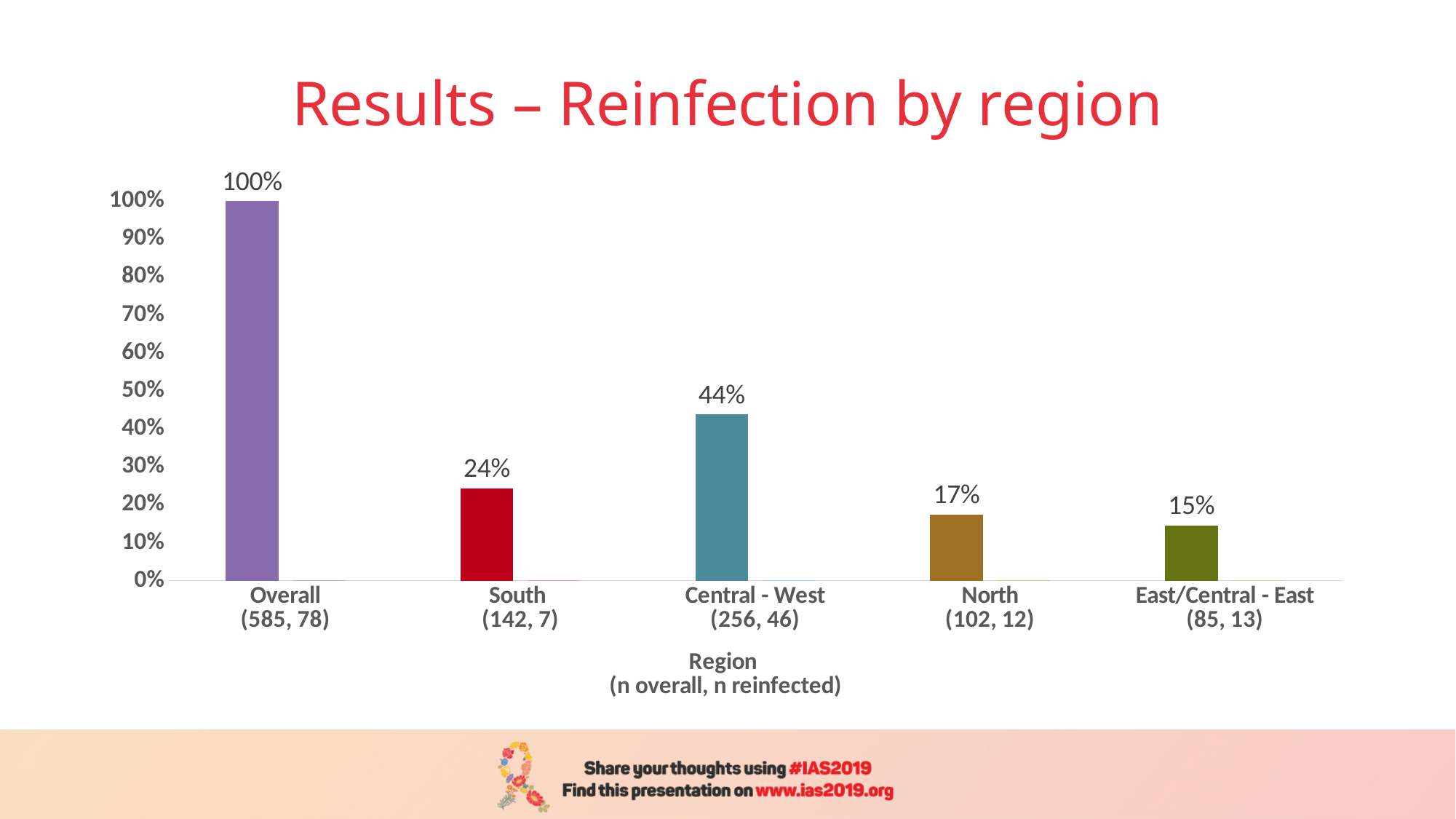
What is the value shown for North? 17% What is the value shown for East/Central - East? 15% What is the x-axis label of the chart? Region (n overall, n reinfected) What is the value shown for Central - West? 44% How many categories are shown on the x axis? 5 What is the difference between the values for Central - West and South? 20% Which category has the lowest value? East/Central - East Which has a larger value, South or North? South What is the value shown for South? 24% What is the title of the slide? Results – Reinfection by region What kind of chart is shown on the slide? Bar chart Which category has the highest value? Overall